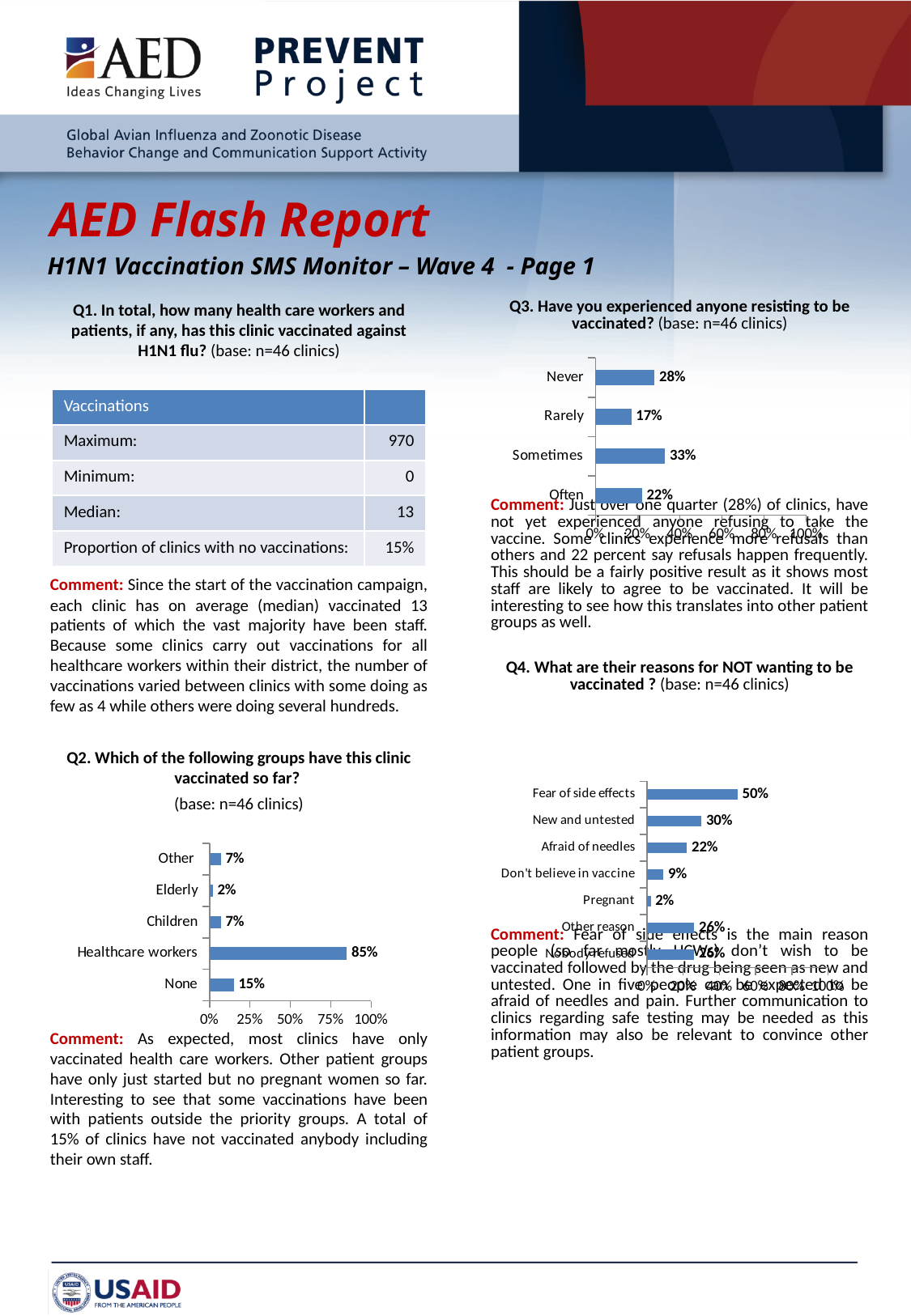
What type of chart is used for Q2? Bar chart In the Q2 chart, what percentage of clinics have vaccinated healthcare workers? 85% How many categories are shown in the Q2 chart? 5 In the Q4 chart, what percentage is shown for Fear of side effects? 50% In the Q3 chart, which response has the lowest value? Rarely In the Q2 chart, which group has the highest value? Healthcare workers In the Q3 chart, which is larger, Never or Often? Never In the Q2 chart, which group has the lowest value? Elderly In the Q4 chart, is the value for Don't believe in vaccine greater or less than 20%? less In the Q2 chart, what is the difference between the values for Healthcare workers and None? 70% In the Q4 chart, what is the difference between New and untested and Afraid of needles? 8% In the Q3 chart, what percentage of clinics answered Sometimes? 33%